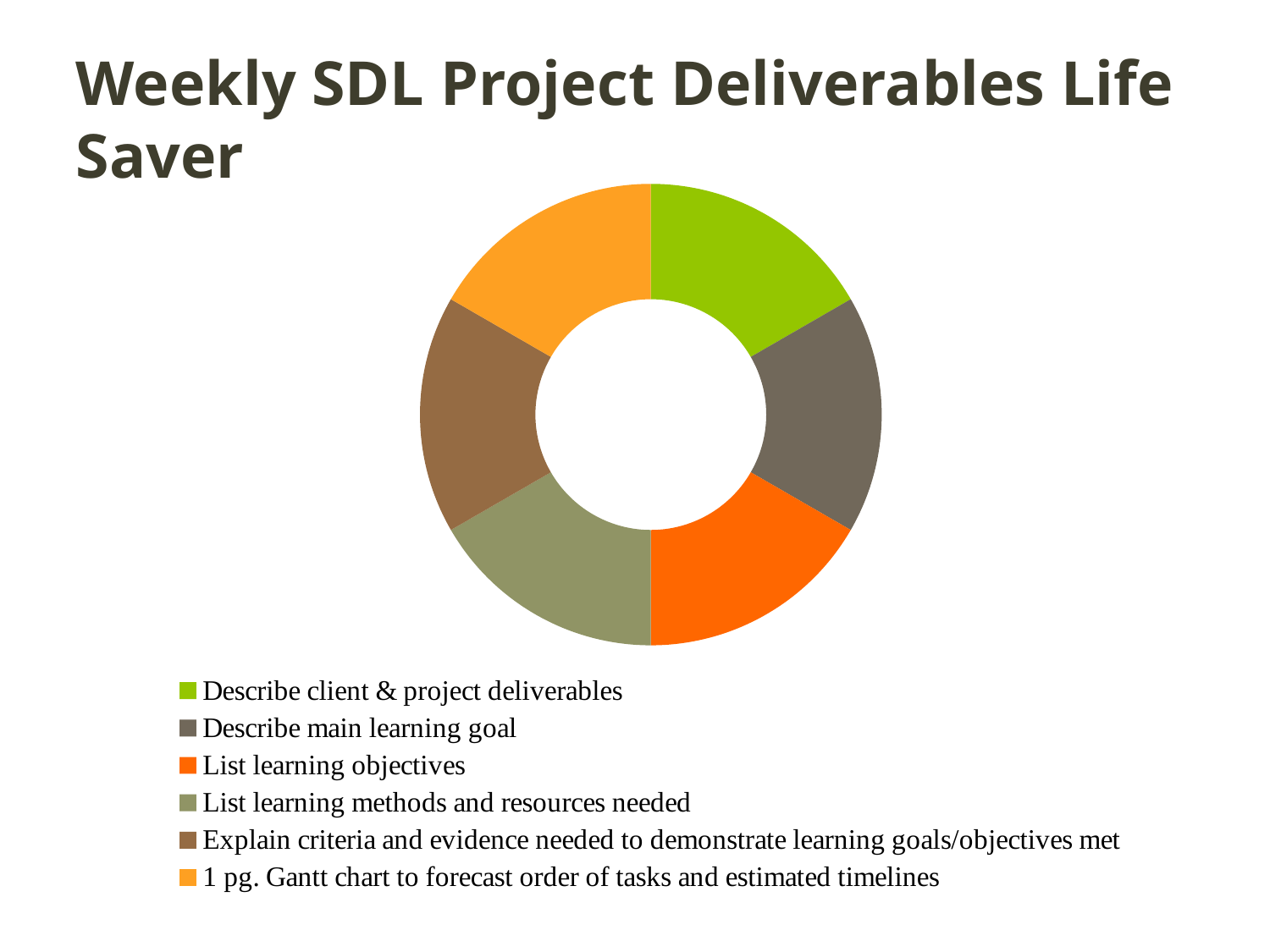
How many categories (slices) does the chart have? 6 What is the title of the slide containing the chart? Weekly SDL Project Deliverables Life Saver What kind of chart is shown on the slide? Doughnut chart Are the slices of the doughnut chart roughly equal in size or clearly different? Roughly equal Which legend entry is listed last in the legend? 1 pg. Gantt chart to forecast order of tasks and estimated timelines Which legend entry is shown in light green? Describe client & project deliverables How many entries does the legend list? 6